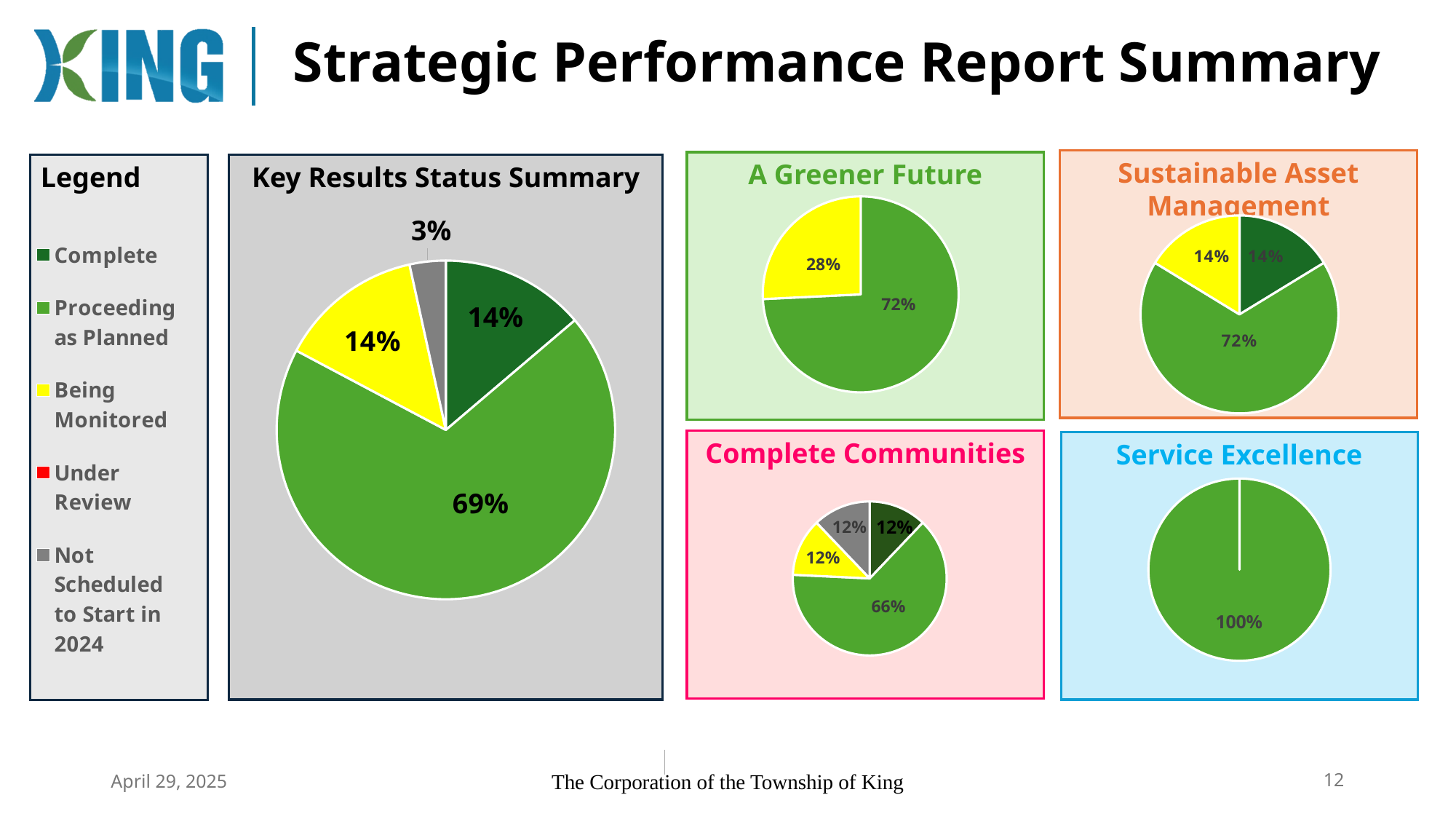
In the Complete Communities chart, what share is Proceeding as Planned? 66% In the Key Results Status Summary chart, what share of key results are Proceeding as Planned? 69% In the Sustainable Asset Management chart, what is the difference between the Proceeding as Planned share and the Being Monitored share? 58 percentage points In the Sustainable Asset Management chart, what share is Complete? 14% In the Service Excellence chart, what share is Proceeding as Planned? 100% In the Key Results Status Summary chart, which status has the largest slice? Proceeding as Planned In the Complete Communities chart, how many slices does the pie have? 4 In the A Greener Future chart, how many slices does the pie have? 2 In the A Greener Future chart, what share is Being Monitored? 28% What kind of chart is used in the Key Results Status Summary panel? Pie chart In the Key Results Status Summary chart, which status has the smallest slice? Not Scheduled to Start in 2024 In the Key Results Status Summary chart, what share of key results are Not Scheduled to Start in 2024? 3%